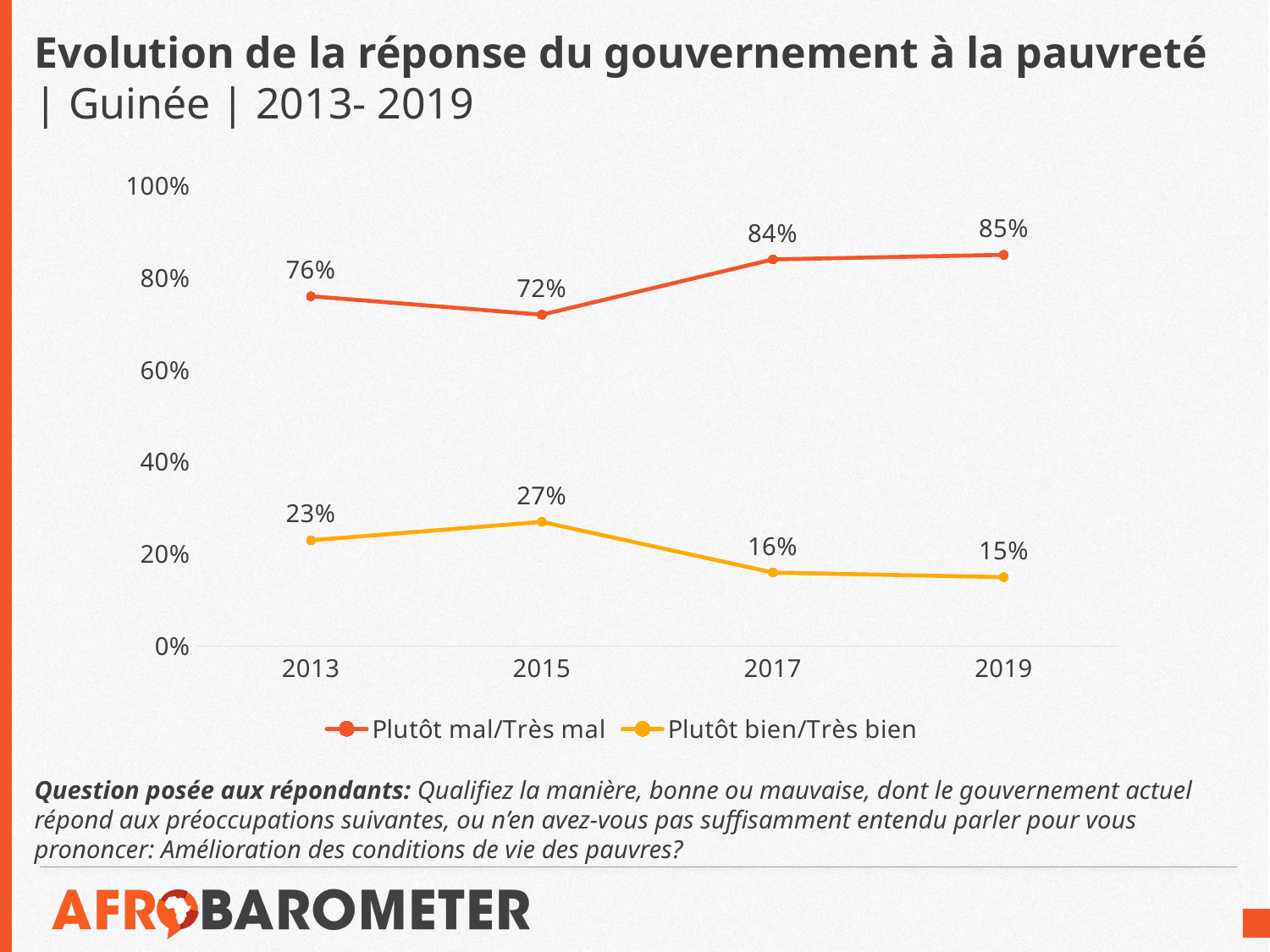
In which year is the "Plutôt bien/Très bien" series at its highest? 2015 What is the value for "Plutôt bien/Très bien" in 2015? 27% In which year is the "Plutôt mal/Très mal" series at its lowest? 2015 How many years are plotted on the x axis? 4 What type of chart is shown on the slide? line chart What is the value for "Plutôt mal/Très mal" in 2017? 84% What colour is the line for "Plutôt bien/Très bien"? yellow How many series does the legend list? 2 Does the "Plutôt bien/Très bien" series rise or fall between 2015 and 2019? fall Which series has the larger value in 2013, "Plutôt mal/Très mal" or "Plutôt bien/Très bien"? Plutôt mal/Très mal What is the difference between the "Plutôt mal/Très mal" value in 2019 and in 2013? 9% Is the value for "Plutôt bien/Très bien" in 2019 greater or less than 20%? less